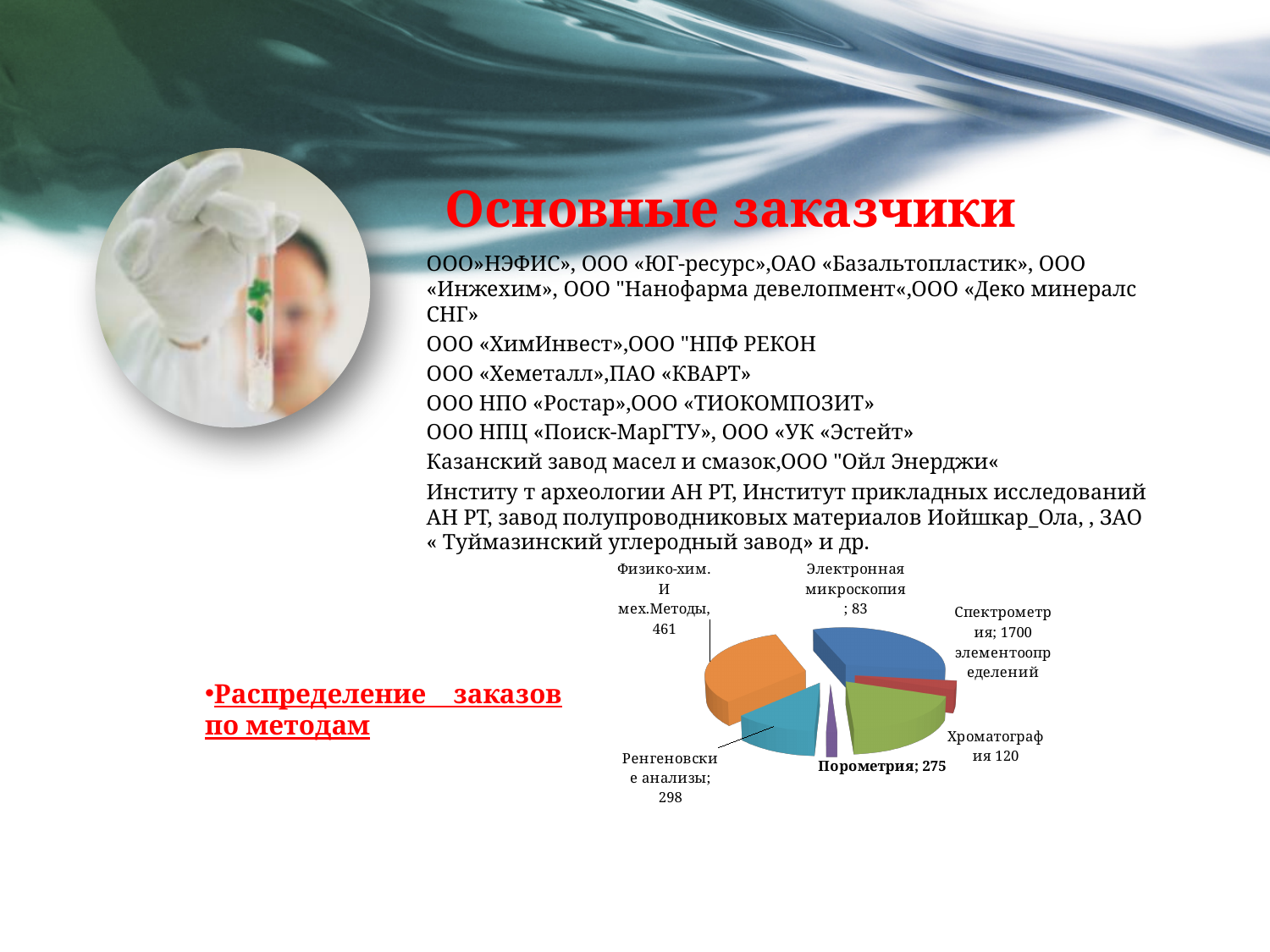
Which is larger: the value for Хроматография or the value for Электронная микроскопия? Хроматография What is the value for Спектрометрия in the pie chart? 1700 What is the heading given for the pie chart on the slide? Распределение заказов по методам What kind of chart is shown on the slide? pie chart What is the value for Порометрия in the pie chart? 275 What is the value for Ренгеновские анализы in the pie chart? 298 What is the value for Физико-хим. и мех. методы in the pie chart? 461 What is the difference between the values for Физико-хим. и мех. методы and Ренгеновские анализы? 163 How many slices does the pie chart have? 6 What is the value for Хроматография in the pie chart? 120